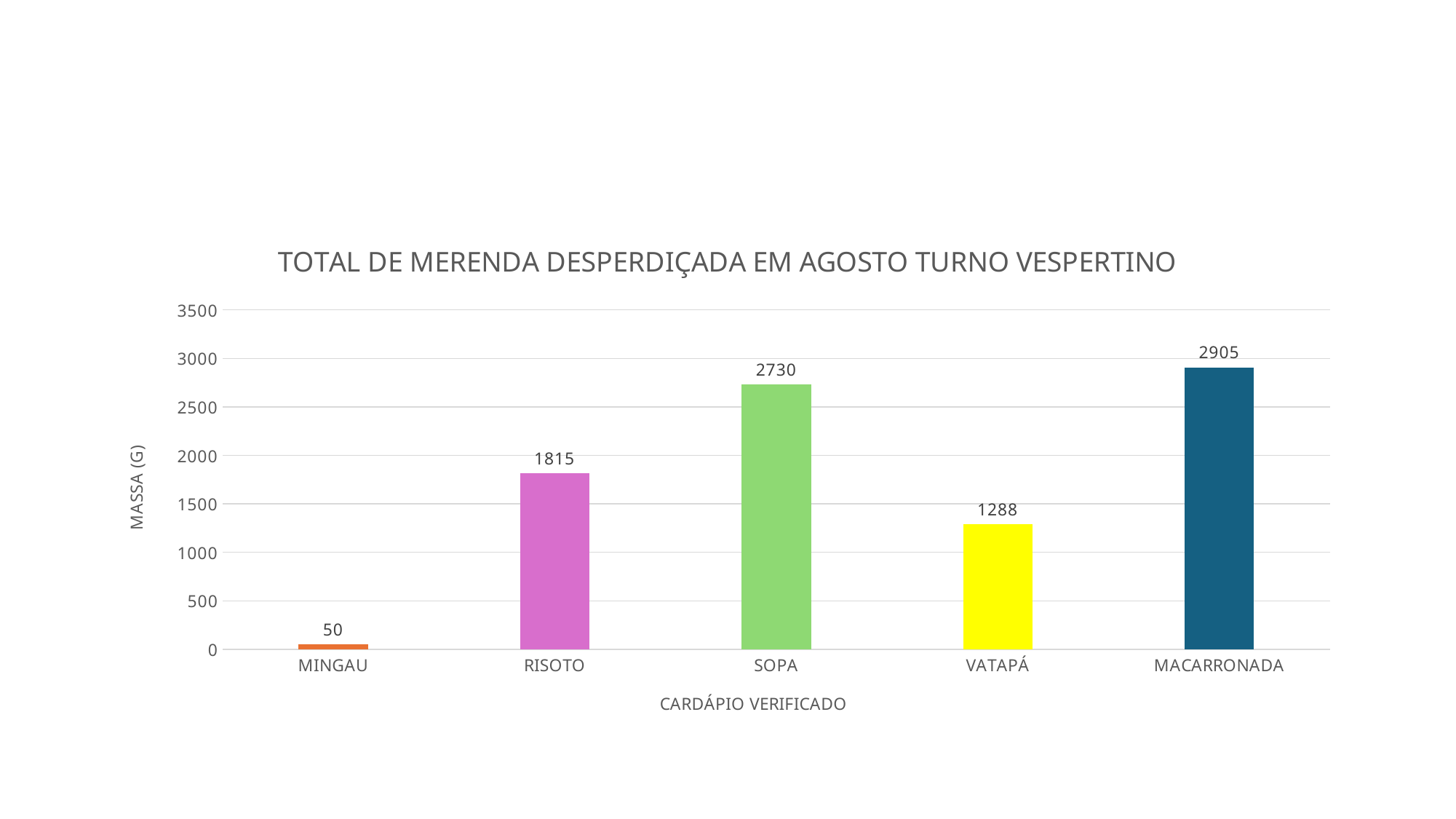
Which is larger, the value for RISOTO or the value for VATAPÁ? RISOTO How many categories are shown on the x axis? 5 Which category has the lowest value? MINGAU What is the value for SOPA? 2730 What is the difference between the values for MACARRONADA and SOPA? 175 What is the difference between the values for RISOTO and VATAPÁ? 527 What is the value for MINGAU? 50 What is the title of the chart? TOTAL DE MERENDA DESPERDIÇADA EM AGOSTO TURNO VESPERTINO What is the value for VATAPÁ? 1288 Is the value for RISOTO greater or less than 2000? less What kind of chart is shown on the slide? bar chart Which category has the highest value? MACARRONADA